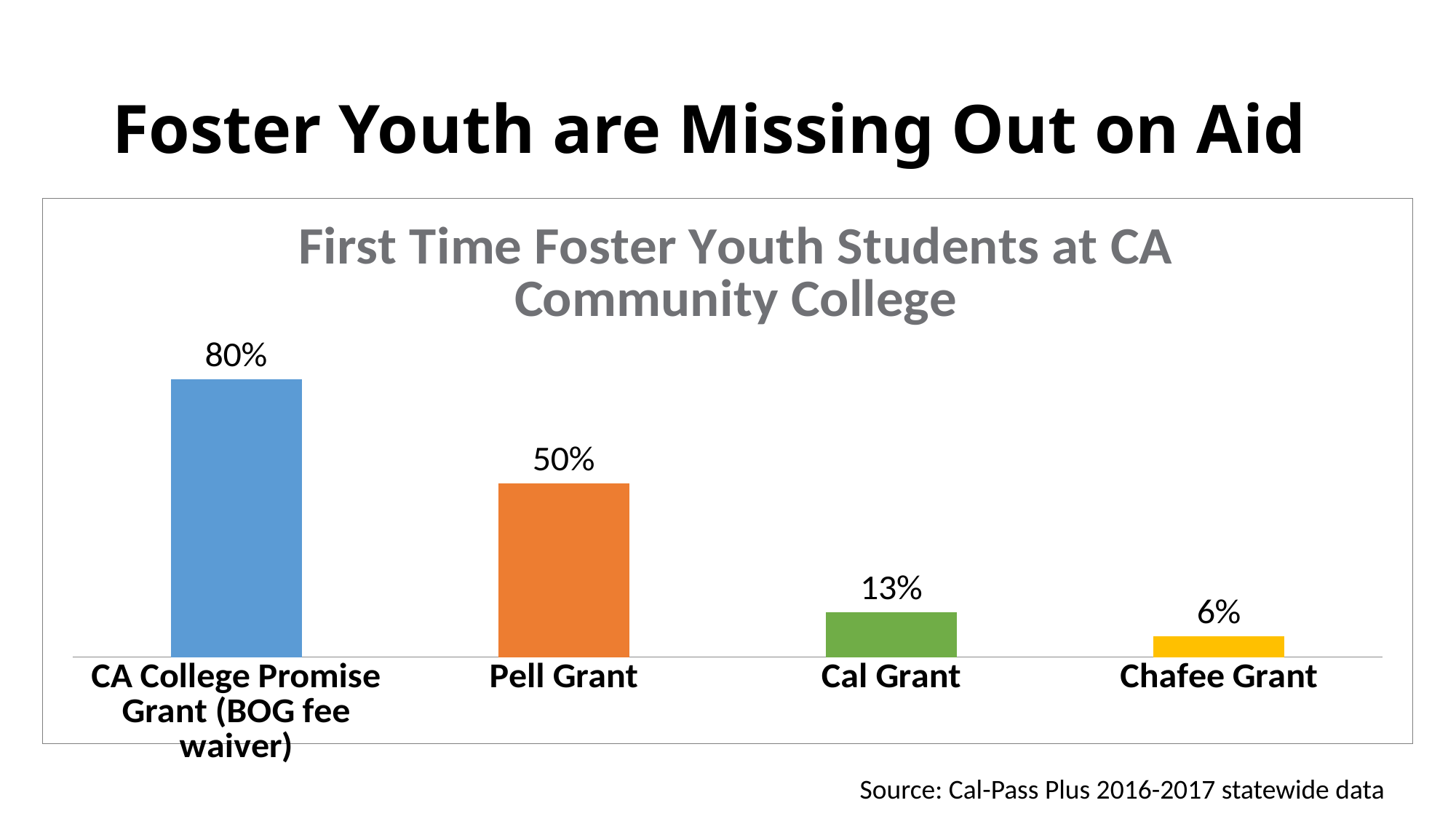
What is the value for Chafee Grant? 6% What is the title of the chart? First Time Foster Youth Students at CA Community College What is the value for Cal Grant? 13% What kind of chart is shown on the slide? Bar chart What is the difference between the values for CA College Promise Grant (BOG fee waiver) and Pell Grant? 30% What is the difference between the values for Cal Grant and Chafee Grant? 7% Which is larger, the value for Pell Grant or the value for Cal Grant? Pell Grant What is the value for Pell Grant? 50% What is the value for CA College Promise Grant (BOG fee waiver)? 80% How many categories are shown in the chart? 4 Which category has the lowest value? Chafee Grant Which category has the highest value? CA College Promise Grant (BOG fee waiver)